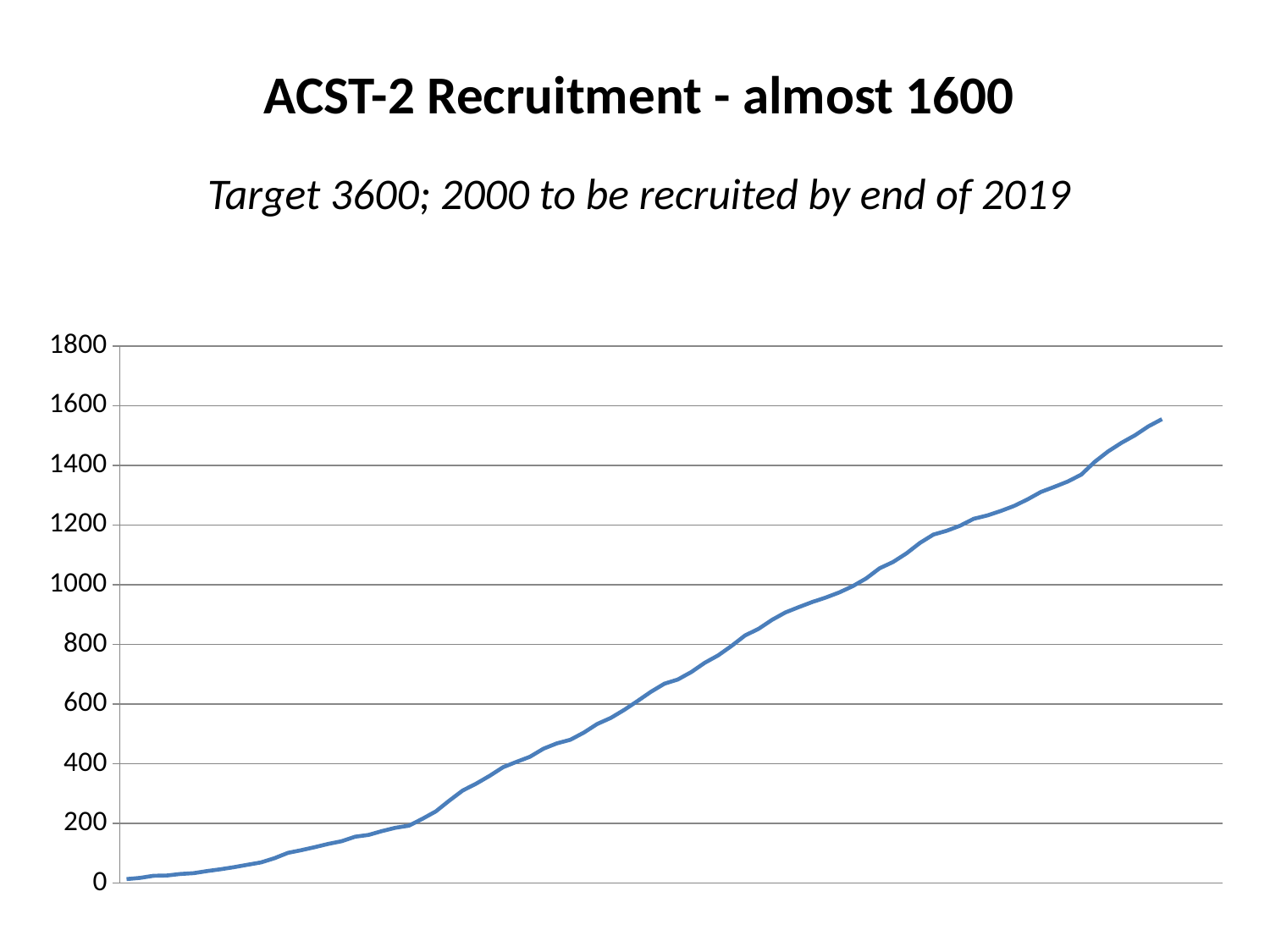
What kind of chart is shown on the slide? line chart Is the starting (leftmost) value of the line greater or less than 200? less What is the highest value shown on the vertical axis? 1800 Does the plotted line rise or fall from left to right? rise How many lines are plotted on the chart? 1 What is the title of the slide containing the chart? ACST-2 Recruitment - almost 1600 Is the final (rightmost) value of the line greater or less than 1600? less Is the final (rightmost) value of the line greater or less than 1400? greater